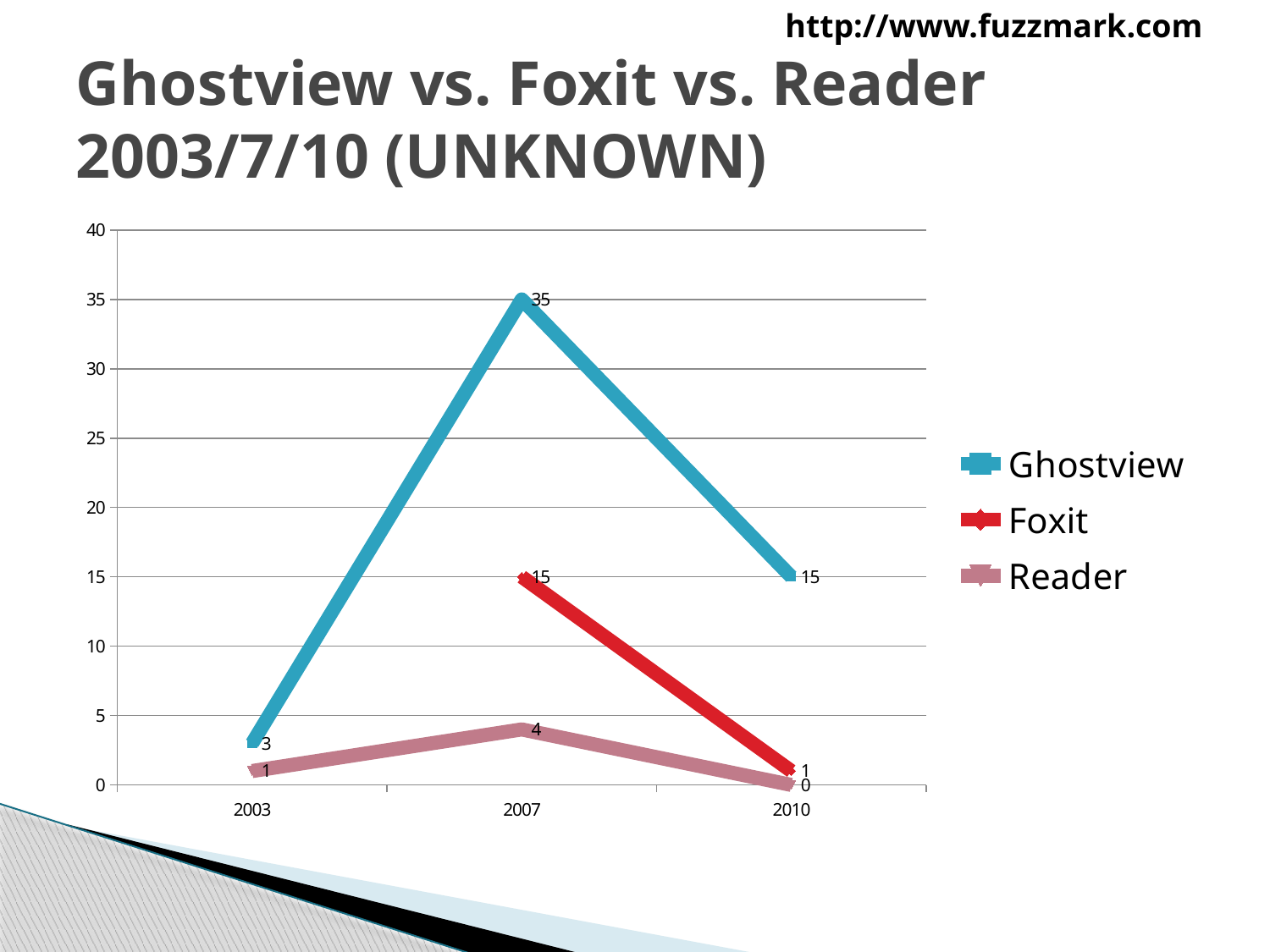
How many years are shown on the x axis? 3 How many series does the legend list? 3 What is the value for Ghostview in 2007? 35 Which is larger in 2007, the Ghostview value or the Foxit value? Ghostview What is the difference between the Ghostview value in 2007 and the Ghostview value in 2010? 20 What is the value for Foxit in 2010? 1 What is the value for Ghostview in 2003? 3 Does the Foxit line rise or fall from 2007 to 2010? fall In which year does Reader have its lowest value? 2010 What is the value for Reader in 2003? 1 What type of chart is shown on the slide? line chart In which year does Ghostview reach its highest value? 2007